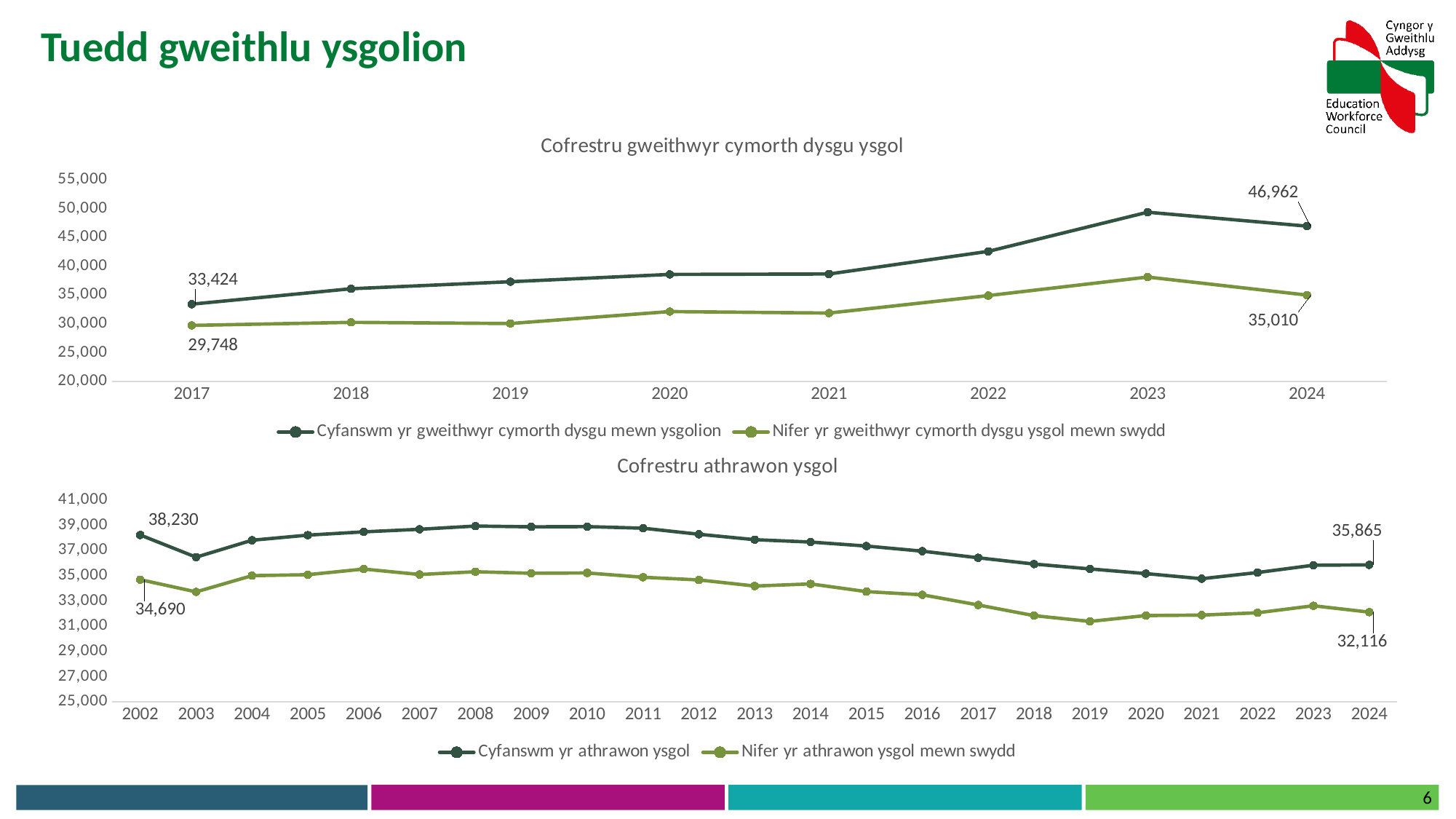
In the chart titled 'Cofrestru athrawon ysgol', is the value for 'Nifer yr athrawon ysgol mewn swydd' in 2019 greater or less than 33,000? less In the chart titled 'Cofrestru gweithwyr cymorth dysgu ysgol', is the value for 'Cyfanswm yr gweithwyr cymorth dysgu mewn ysgolion' in 2023 greater or less than 45,000? greater In the chart titled 'Cofrestru gweithwyr cymorth dysgu ysgol', by how much did 'Cyfanswm yr gweithwyr cymorth dysgu mewn ysgolion' increase from 2017 to 2024? 13,538 How many series does the legend of the chart titled 'Cofrestru gweithwyr cymorth dysgu ysgol' list? 2 In the chart titled 'Cofrestru gweithwyr cymorth dysgu ysgol', what is the value for 'Nifer yr gweithwyr cymorth dysgu ysgol mewn swydd' in 2017? 29,748 In the chart titled 'Cofrestru athrawon ysgol', what is the value for 'Cyfanswm yr athrawon ysgol' in 2002? 38,230 In the chart titled 'Cofrestru athrawon ysgol', what is the difference between 'Cyfanswm yr athrawon ysgol' in 2002 and in 2024? 2,365 How many years are plotted on the x axis of the chart titled 'Cofrestru athrawon ysgol'? 23 What kind of chart is the chart titled 'Cofrestru athrawon ysgol'? Line chart In the chart titled 'Cofrestru gweithwyr cymorth dysgu ysgol', what is the value for 'Cyfanswm yr gweithwyr cymorth dysgu mewn ysgolion' in 2024? 46,962 In the chart titled 'Cofrestru athrawon ysgol', what is the value for 'Nifer yr athrawon ysgol mewn swydd' in 2024? 32,116 In the chart titled 'Cofrestru gweithwyr cymorth dysgu ysgol', in which year does 'Cyfanswm yr gweithwyr cymorth dysgu mewn ysgolion' reach its highest value? 2023